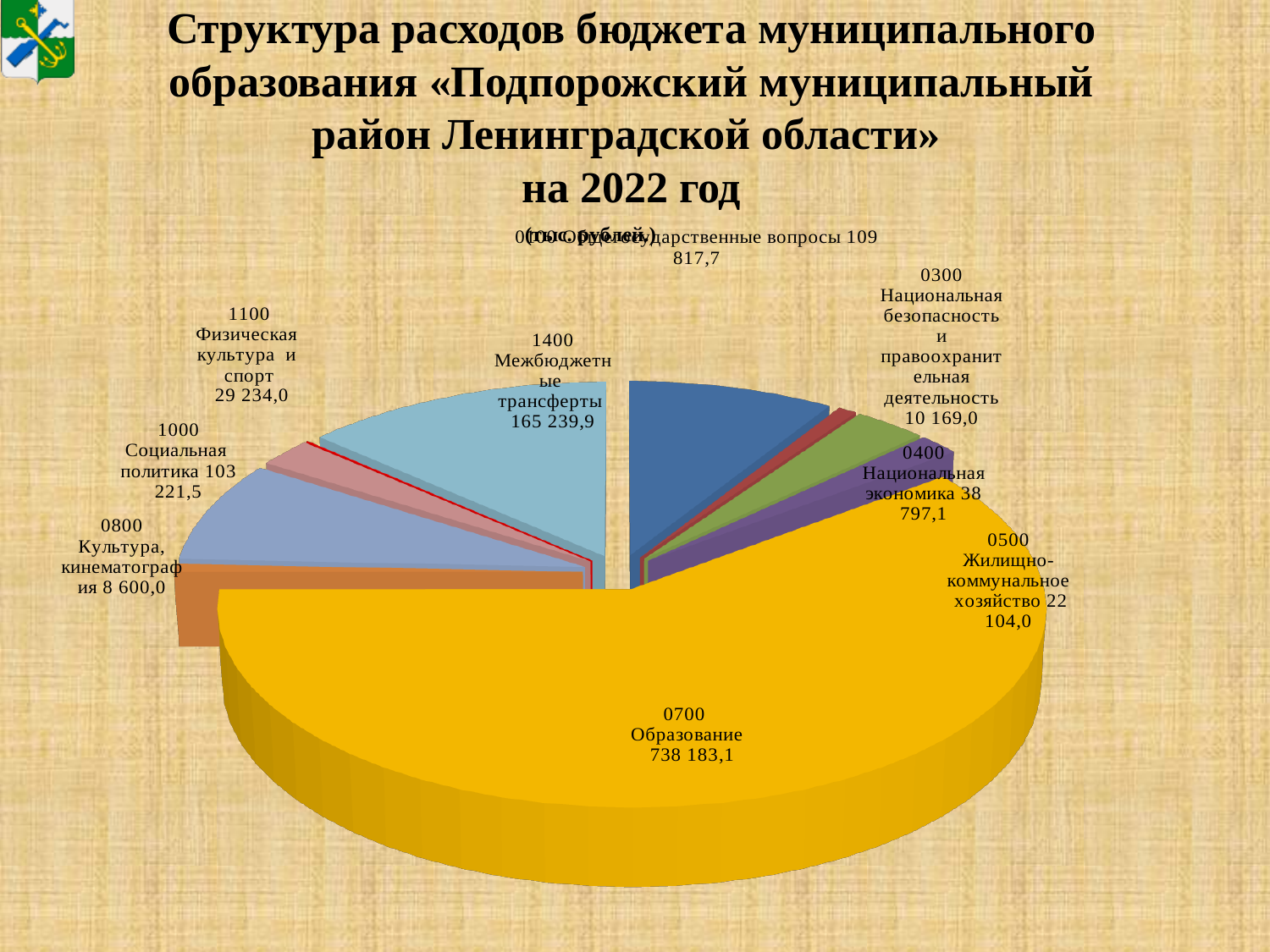
What is the difference between 1400 Межбюджетные трансферты and 1000 Социальная политика? 62 018,4 What is the value for 0800 Культура, кинематография? 8 600,0 What is the value for 1000 Социальная политика? 103 221,5 What kind of chart is shown on the slide? Pie chart What is the value for 1400 Межбюджетные трансферты? 165 239,9 What is the value for 0700 Образование? 738 183,1 Which is larger: 0400 Национальная экономика or 0500 Жилищно-коммунальное хозяйство? 0400 Национальная экономика How many categories (slices) does the pie chart show? 10 What is the difference between 1100 Физическая культура и спорт and 0300 Национальная безопасность и правоохранительная деятельность? 19 065,0 Which category has the largest slice of the pie? 0700 Образование What is the value for 0400 Национальная экономика? 38 797,1